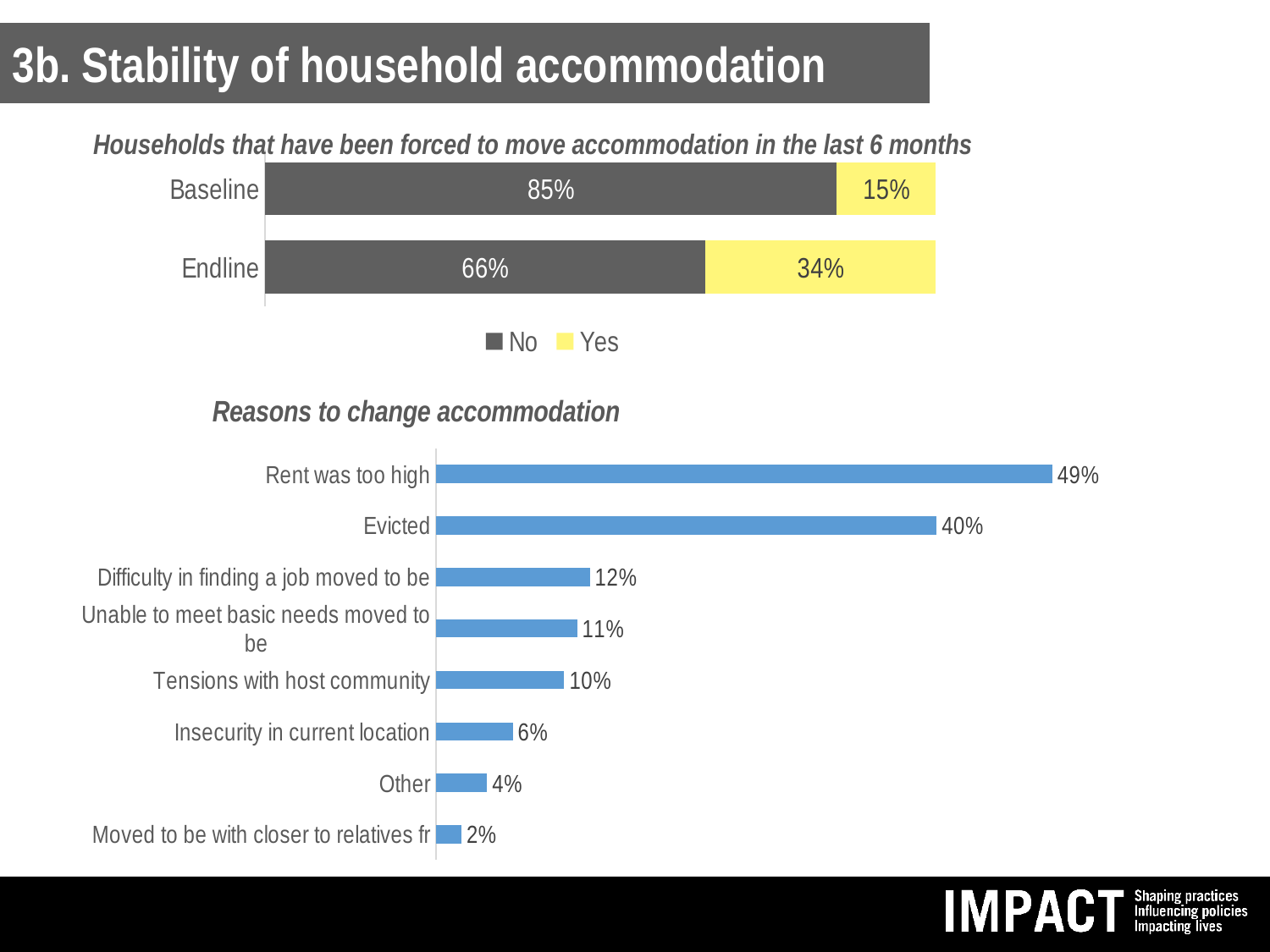
In the 'Reasons to change accommodation' chart, how many reasons are listed? 8 In the 'Households that have been forced to move accommodation in the last 6 months' chart, by how many percentage points did the 'Yes' share increase from Baseline to Endline? 19 percentage points In the 'Households that have been forced to move accommodation in the last 6 months' chart, how many series does the legend list? 2 In the 'Reasons to change accommodation' chart, what is the value for 'Evicted'? 40% In the 'Households that have been forced to move accommodation in the last 6 months' chart, what is the total of the Endline stacked bar? 100% In the 'Reasons to change accommodation' chart, which reason has the highest value? Rent was too high What kind of chart is the 'Reasons to change accommodation' chart? Bar chart In the 'Households that have been forced to move accommodation in the last 6 months' chart, what is the 'Yes' value at Endline? 34% In the 'Households that have been forced to move accommodation in the last 6 months' chart, what is the 'No' value at Baseline? 85% In the 'Reasons to change accommodation' chart, which is larger: 'Tensions with host community' or 'Insecurity in current location'? Tensions with host community In the 'Reasons to change accommodation' chart, which reason has the lowest value? Moved to be with closer to relatives fr In the 'Reasons to change accommodation' chart, what is the difference between 'Rent was too high' and 'Evicted'? 9 percentage points